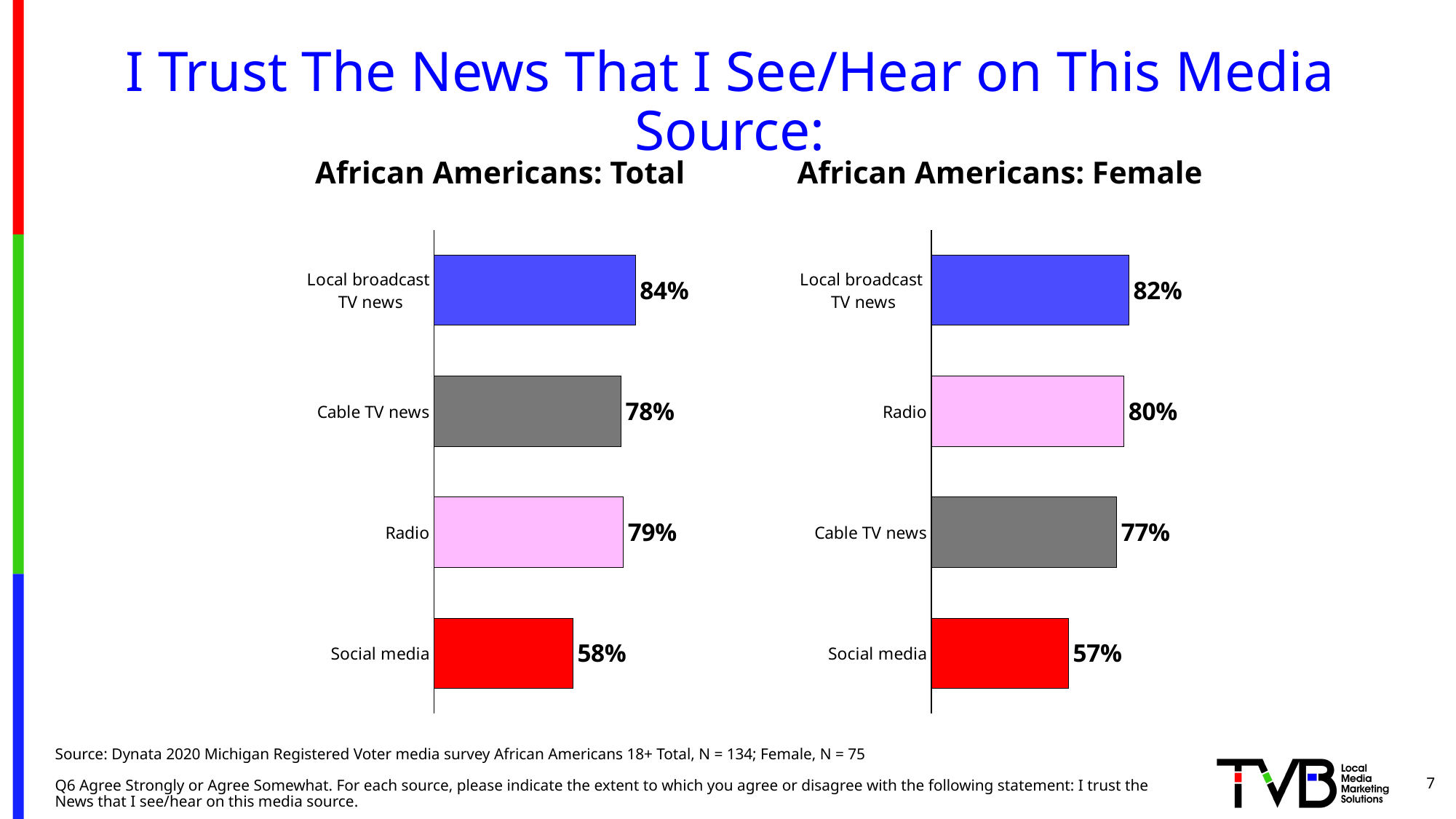
In the 'African Americans: Female' chart, which category has the lowest value? Social media In the 'African Americans: Total' chart, what is the difference between Local broadcast TV news and Social media? 26% In the 'African Americans: Total' chart, what is the value for Local broadcast TV news? 84% In the 'African Americans: Female' chart, what is the value for Radio? 80% Which is larger: Local broadcast TV news in the 'African Americans: Total' chart or Local broadcast TV news in the 'African Americans: Female' chart? African Americans: Total In the 'African Americans: Total' chart, which category has the highest value? Local broadcast TV news In the 'African Americans: Female' chart, what is the difference between Radio and Cable TV news? 3% What kind of chart is the 'African Americans: Total' chart? Bar chart In the 'African Americans: Female' chart, what is the value for Cable TV news? 77% In the 'African Americans: Total' chart, what colour is the Social media bar? Red In the 'African Americans: Total' chart, what is the value for Social media? 58% How many categories are shown in the 'African Americans: Female' chart? 4